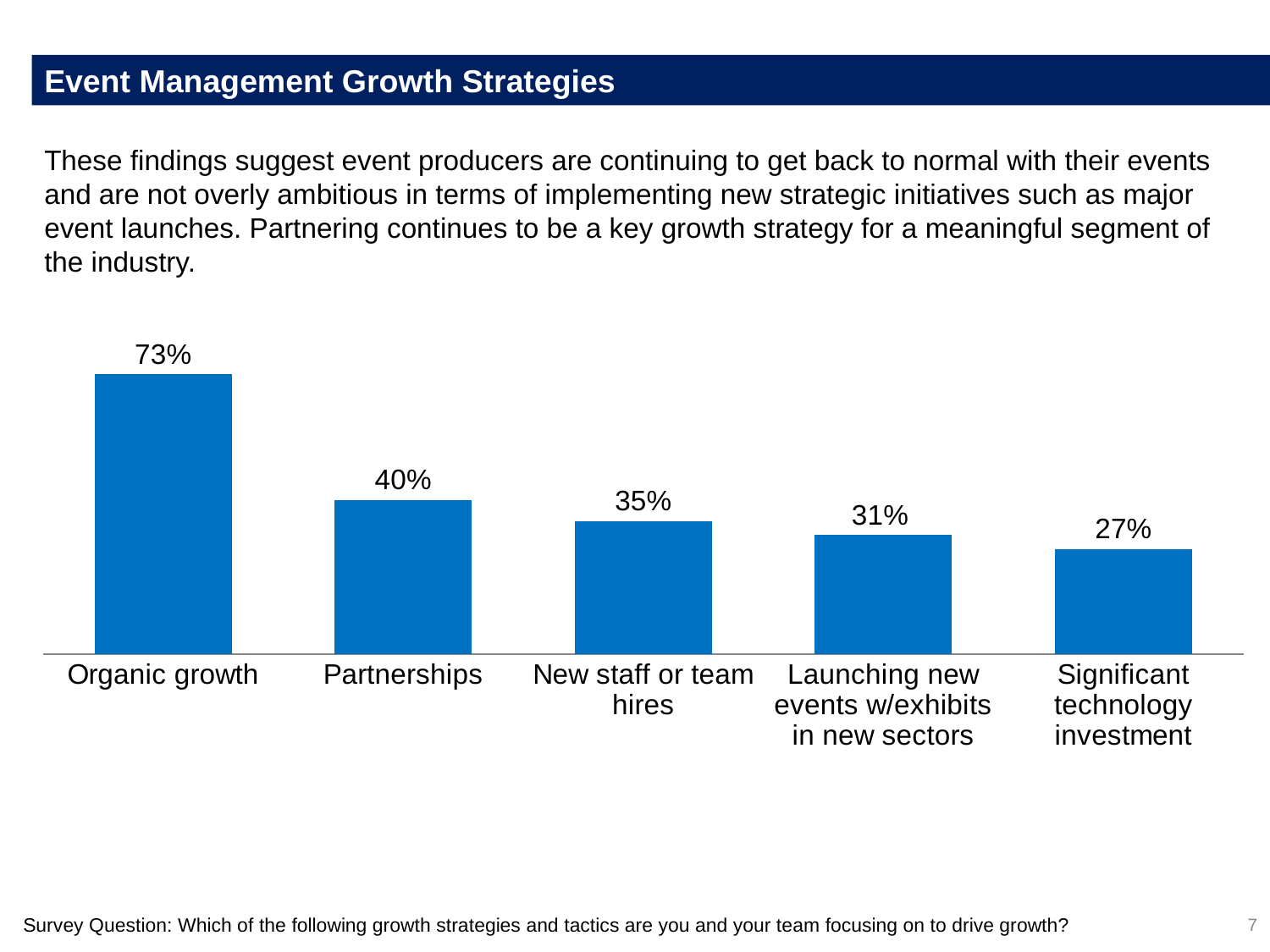
How many growth strategies are shown in the chart? 5 What kind of chart is shown on the slide? Bar chart What is the difference between the values for Organic growth and Partnerships? 33% What is the value shown for Launching new events w/exhibits in new sectors? 31% Do the values rise or fall from left to right across the chart? Fall Which is larger, the value for New staff or team hires or the value for Significant technology investment? New staff or team hires Which growth strategy has the lowest value? Significant technology investment What is the value shown for Significant technology investment? 27% Which growth strategy has the highest value? Organic growth What is the value shown for New staff or team hires? 35% What is the value shown for Partnerships? 40% What percentage of respondents are focusing on Organic growth? 73%